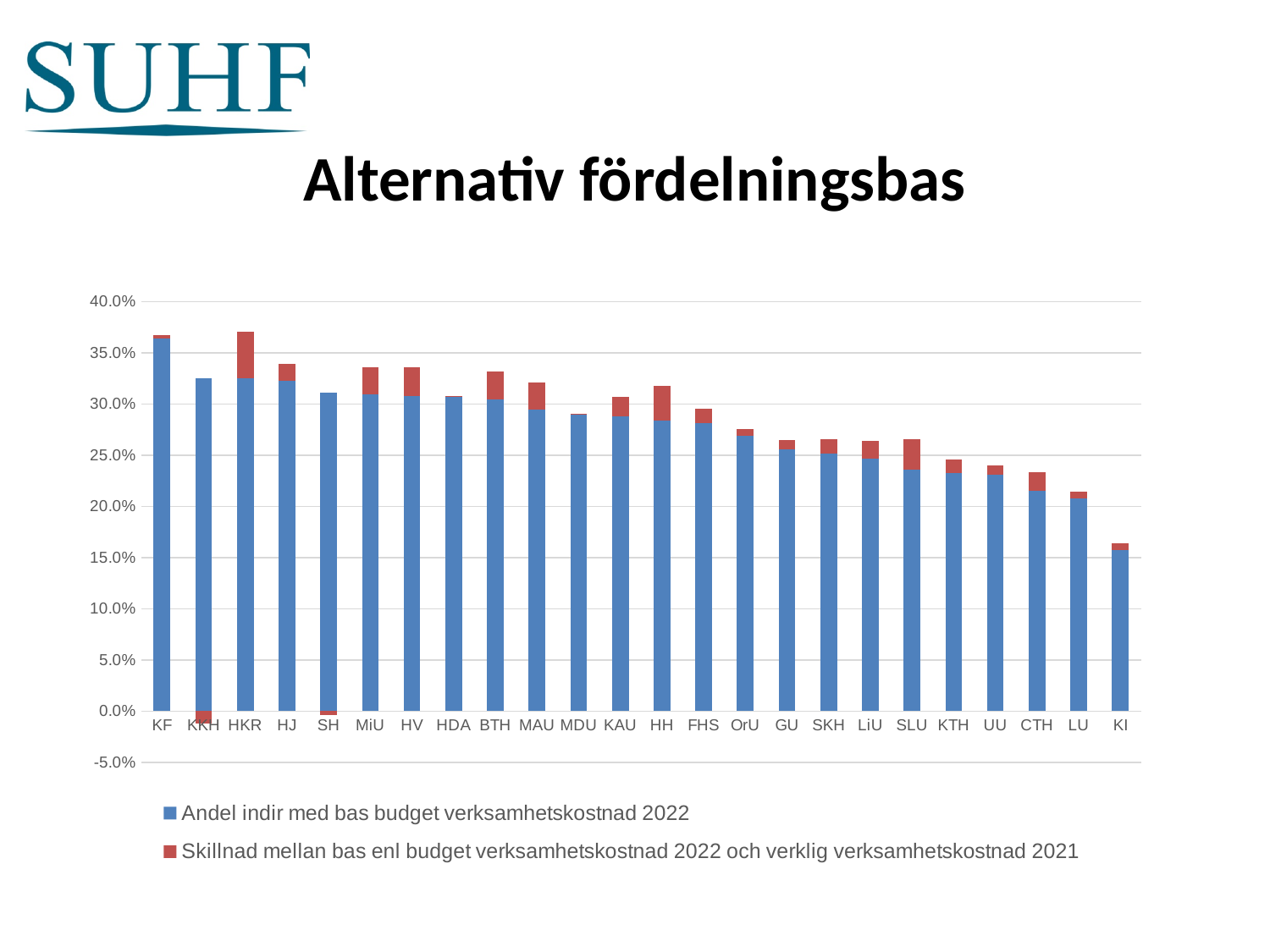
How many series does the legend list? 2 Which category has the highest value for 'Andel indir med bas budget verksamhetskostnad 2022'? KF What type of chart is shown on the slide? stacked bar chart Do the values for 'Andel indir med bas budget verksamhetskostnad 2022' generally rise or fall from left to right along the x axis? fall Which colour represents 'Skillnad mellan bas enl budget verksamhetskostnad 2022 och verklig verksamhetskostnad 2021' in the legend? red How many categories (institutions) are shown on the x axis? 24 Is the value for KF in the series 'Andel indir med bas budget verksamhetskostnad 2022' greater or less than 35.0%? greater Which is larger for 'Andel indir med bas budget verksamhetskostnad 2022': KF or KI? KF What is the title of the chart? Alternativ fördelningsbas Which category has the lowest value for 'Andel indir med bas budget verksamhetskostnad 2022'? KI Is the value for MDU in the series 'Andel indir med bas budget verksamhetskostnad 2022' greater or less than 30.0%? less Is the value for KI in the series 'Andel indir med bas budget verksamhetskostnad 2022' greater or less than 20.0%? less